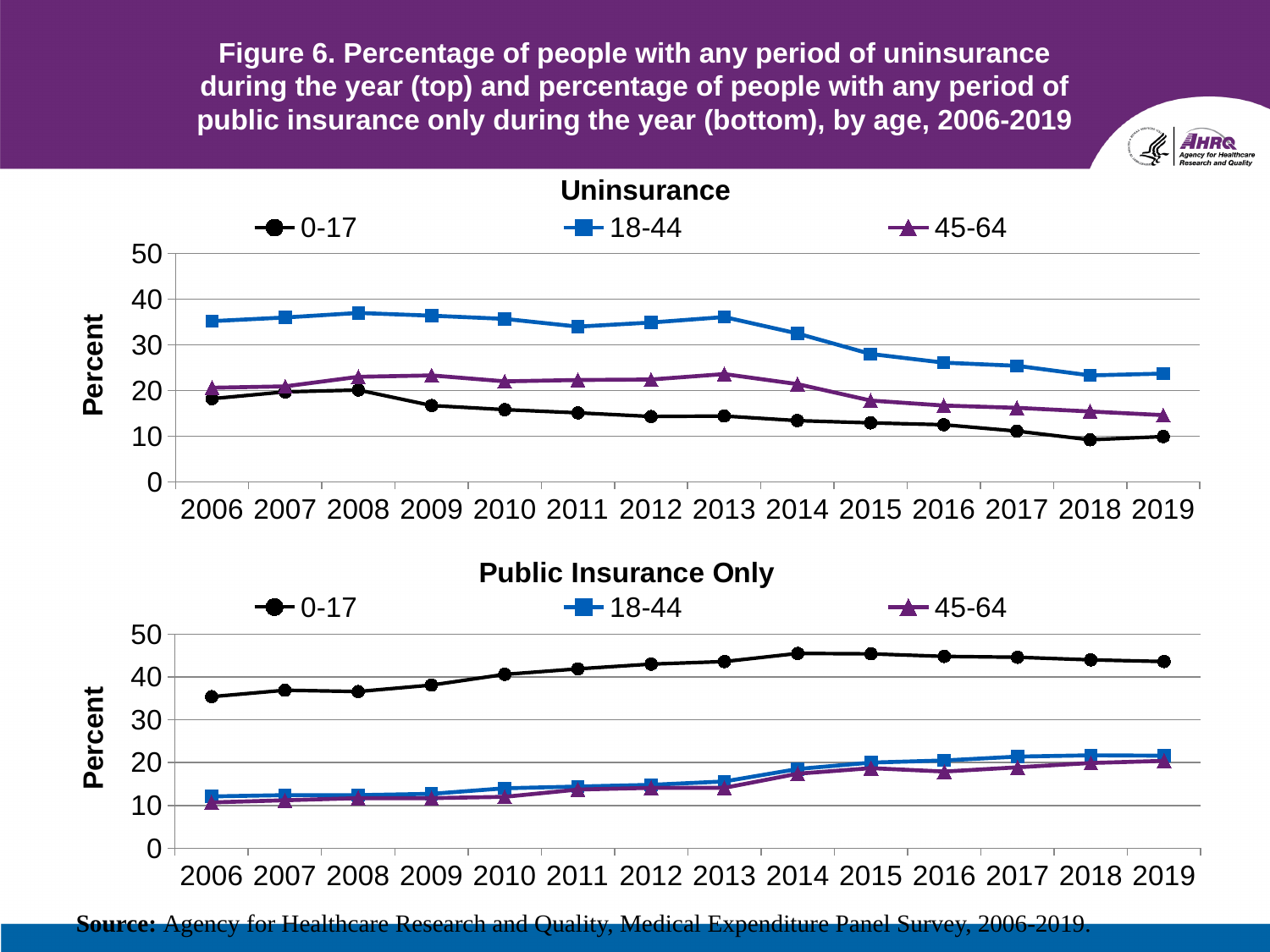
In the Public Insurance Only chart, does the 0-17 line rise or fall overall from 2006 to 2019? rise In the Uninsurance chart, is the value for 18-44 in 2019 greater or less than 20? greater In the Uninsurance chart, does the 18-44 line rise or fall overall from 2006 to 2019? fall How many years are shown on the x axis of the Uninsurance chart? 14 In the Public Insurance Only chart, which age group has the highest value in 2015? 0-17 In the Uninsurance chart, which age group has the highest value in 2013? 18-44 In the Public Insurance Only chart, is the value for 0-17 in 2014 greater or less than 40? greater In the Public Insurance Only chart, which is larger in 2016: the value for 18-44 or the value for 45-64? 18-44 In the Uninsurance chart, which is larger in 2009: the value for 45-64 or the value for 0-17? 45-64 In the Uninsurance chart, which age group has the lowest value in 2019? 0-17 How many series does the legend of the Public Insurance Only chart list? 3